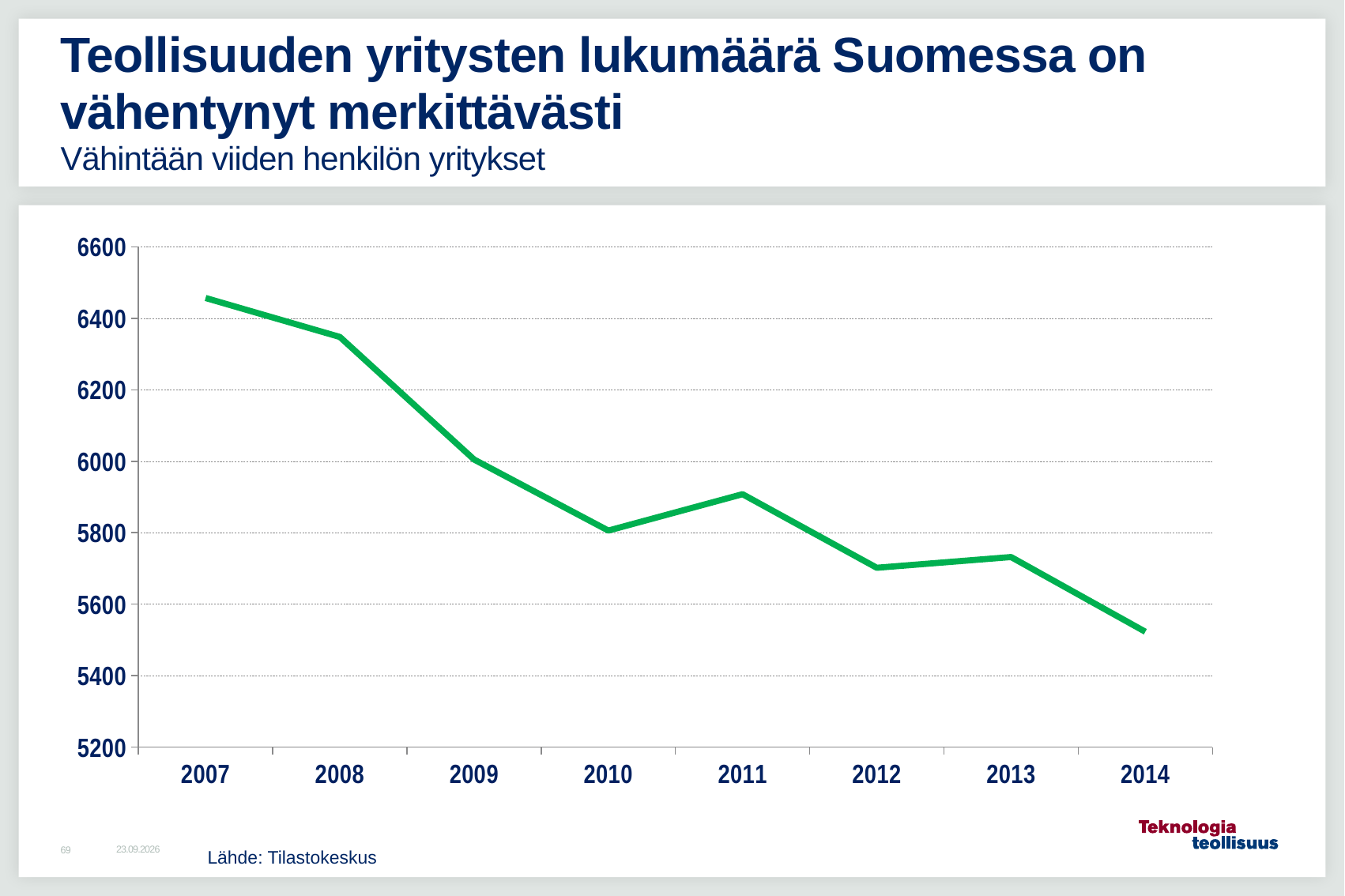
Which year has the highest value? 2007 Which year has the larger value, 2010 or 2011? 2011 Is the value for 2014 greater or less than 5600? less Is the value for 2011 greater or less than 6000? less Is the value for 2007 greater or less than 6400? greater How many years are plotted on the x axis? 8 Which year has the larger value, 2008 or 2009? 2008 What kind of chart is shown on the slide? line chart Which year has the lowest value? 2014 Do the values generally rise or fall from 2007 to 2014? fall What source is cited below the chart? Tilastokeskus